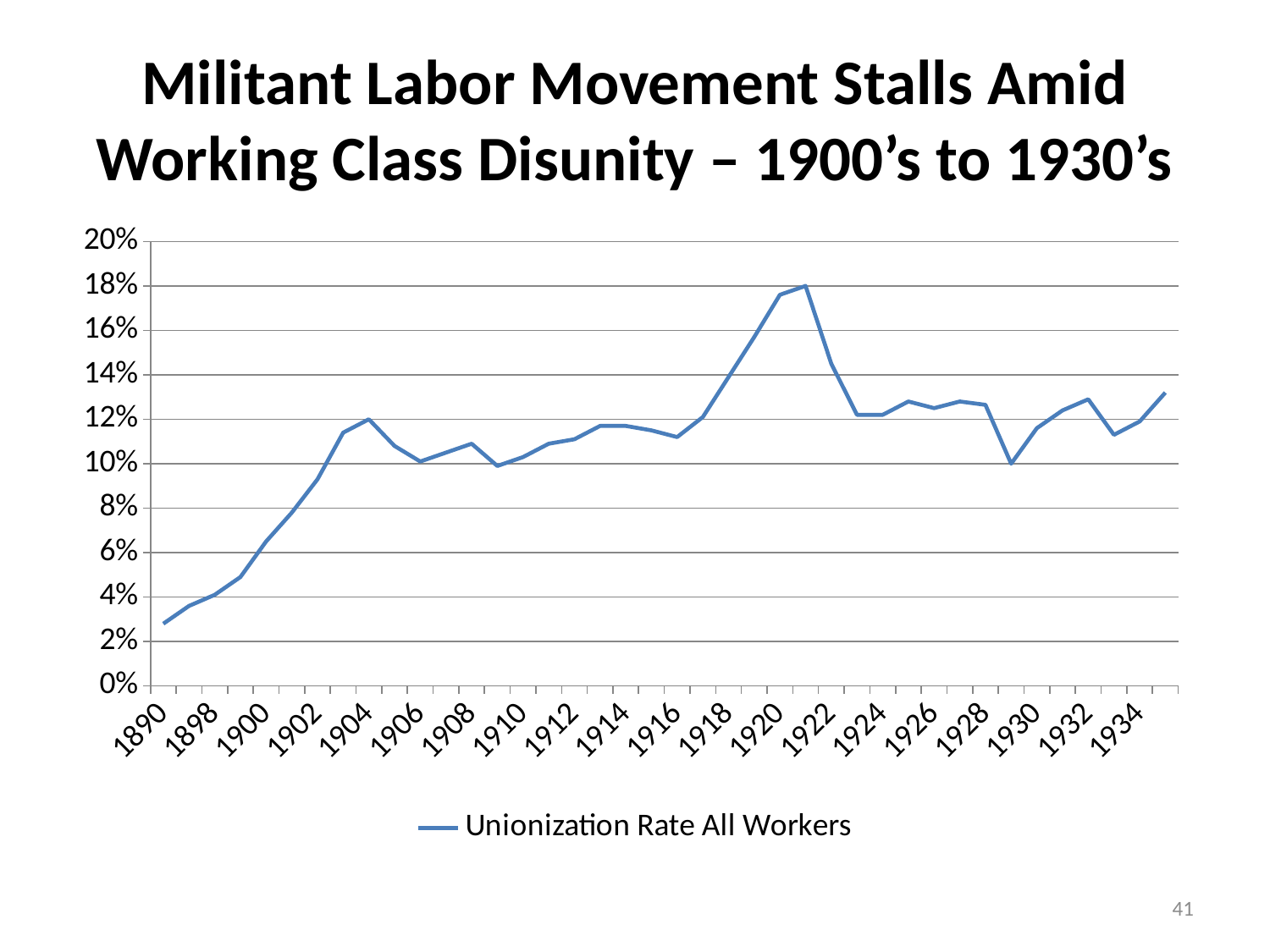
Is the unionization rate for 1890 greater or less than 4%? less What kind of chart is shown on the slide? line chart Is the unionization rate for 1904 greater or less than 10%? greater How many series does the legend list? 1 Is the unionization rate for 1900 greater or less than 8%? less Which year has the higher unionization rate, 1890 or 1934? 1934 Which year has the higher unionization rate, 1920 or 1924? 1920 What is the name of the series shown in the legend? Unionization Rate All Workers Does the unionization rate rise or fall between 1890 and 1904? rise Which labeled year has the lowest unionization rate? 1890 What is the highest value shown on the vertical axis? 20%